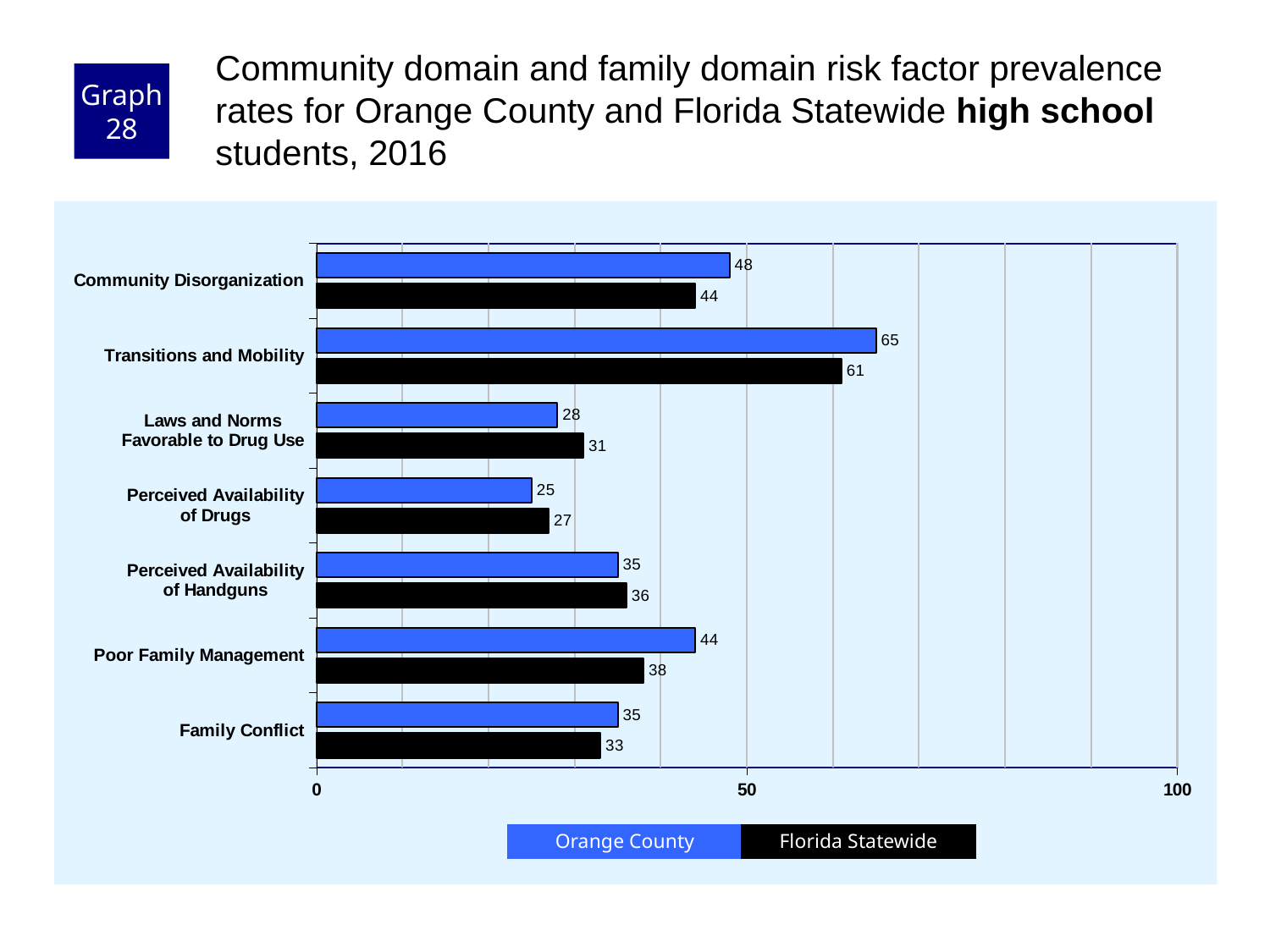
What is the Florida Statewide value for Perceived Availability of Drugs? 27 What is the difference between the Orange County and Florida Statewide values for Community Disorganization? 4 How many series does the legend list? 2 Which risk factor has the highest Orange County value? Transitions and Mobility Which colour represents Florida Statewide in the chart? Black Is the Florida Statewide value for Transitions and Mobility greater or less than 50? greater What is the Orange County value for Transitions and Mobility? 65 For Laws and Norms Favorable to Drug Use, which is larger: the Orange County value or the Florida Statewide value? Florida Statewide Which risk factor has the lowest Florida Statewide value? Perceived Availability of Drugs How many risk factor categories are shown on the chart? 7 What kind of chart is shown on the slide? Bar chart What is the Florida Statewide value for Poor Family Management? 38